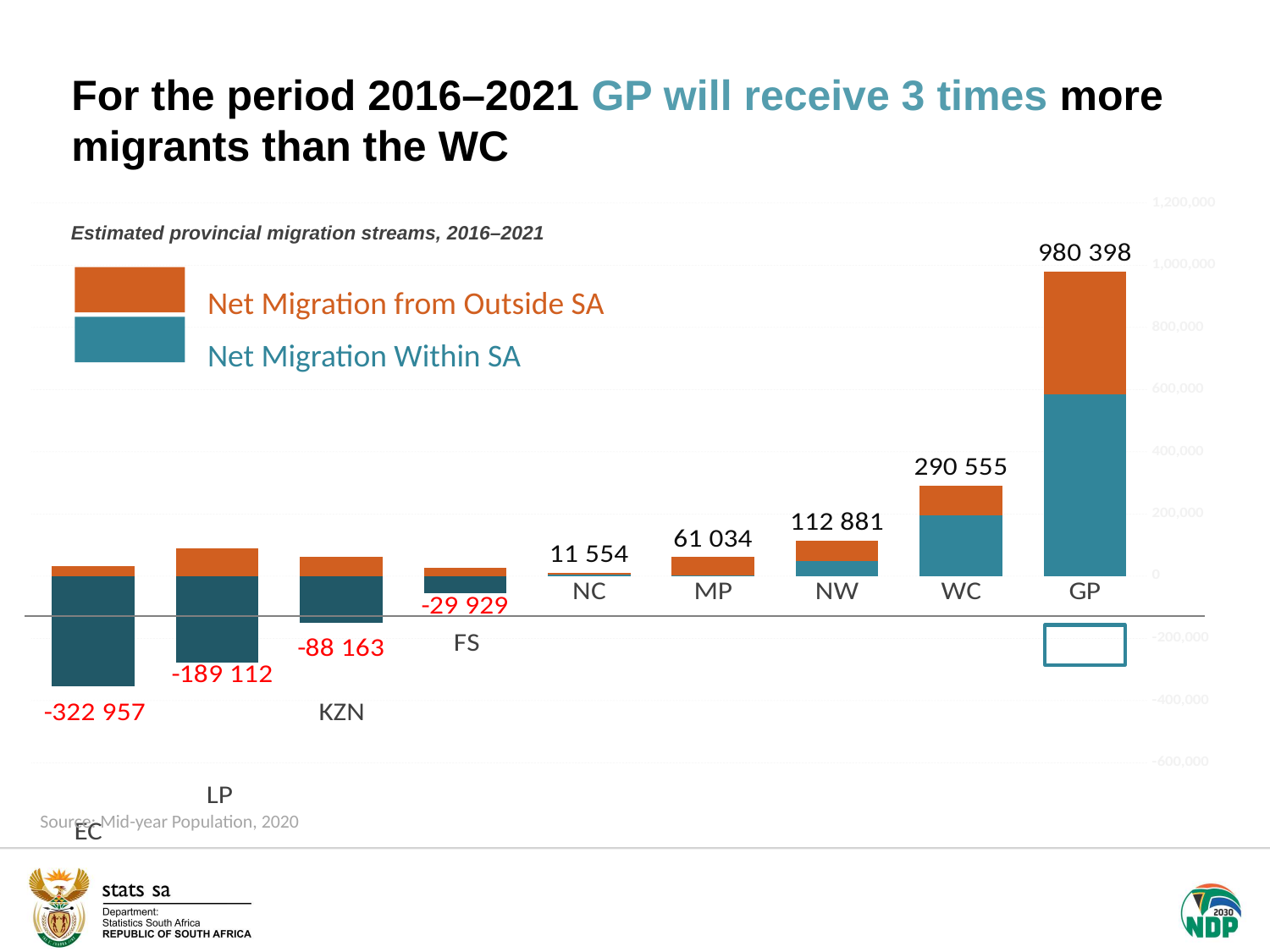
What is the labelled value for GP? 980 398 What kind of chart is shown on the slide? Stacked bar chart Is the value for GP greater or less than 800,000? greater Which province has the lowest labelled value? EC What is the labelled value for NC? 11 554 What is the labelled value for EC? -322 957 What is the labelled value for WC? 290 555 What is the difference between the labelled values for GP and WC? 689 843 How many series does the legend list? 2 How many provinces are shown on the x axis? 9 Which has the larger labelled value, NW or MP? NW Which province has the highest labelled value? GP